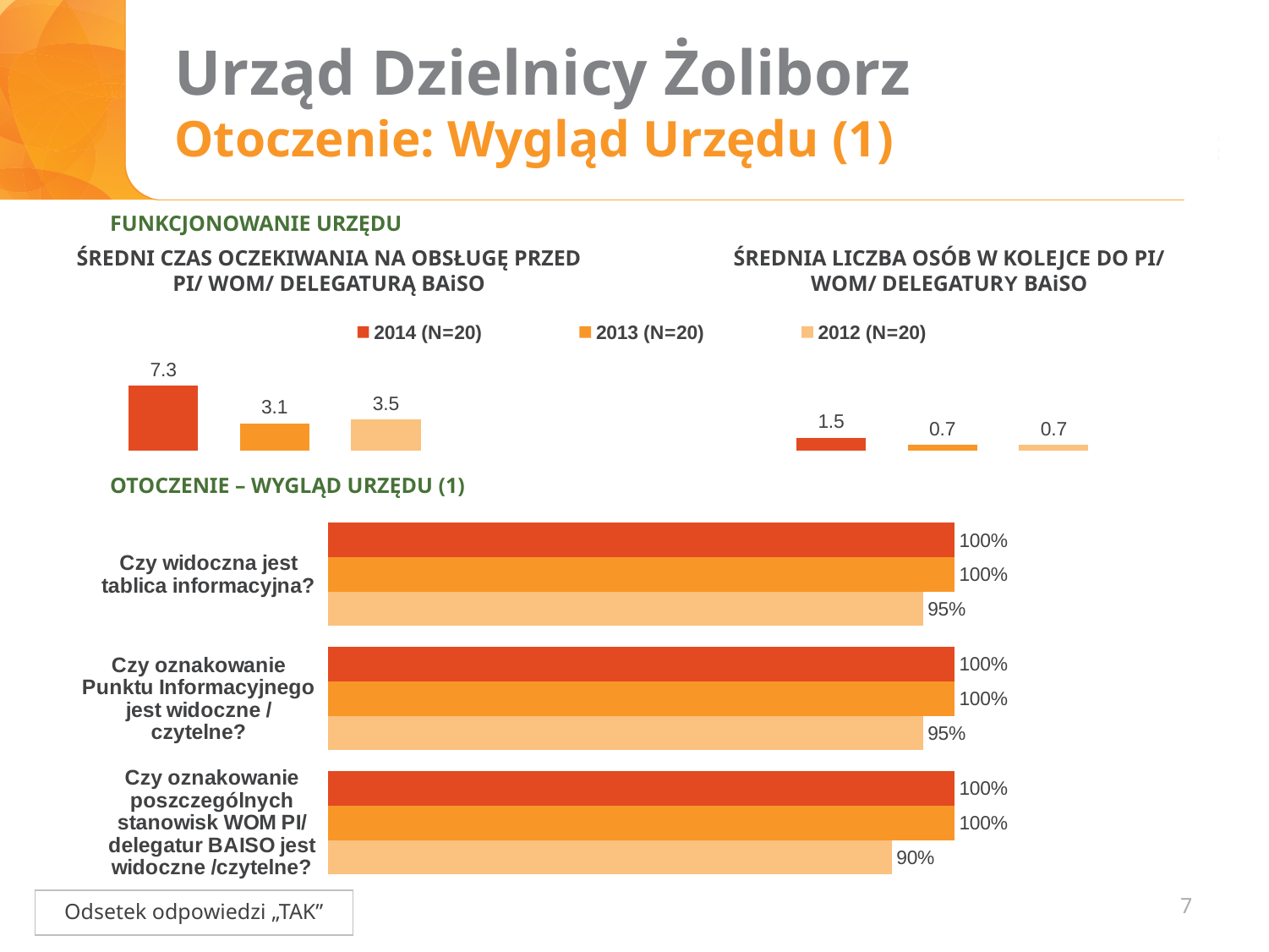
In the chart 'ŚREDNIA LICZBA OSÓB W KOLEJCE DO PI/ WOM/ DELEGATURY BAiSO', what is the value for 2014 (N=20)? 1.5 In the bottom chart 'OTOCZENIE – WYGLĄD URZĘDU (1)', what is the 2012 value for 'Czy oznakowanie poszczególnych stanowisk WOM PI/ delegatur BAISO jest widoczne /czytelne?'? 90% In the chart 'ŚREDNI CZAS OCZEKIWANIA NA OBSŁUGĘ PRZED PI/ WOM/ DELEGATURĄ BAiSO', which year has the highest value? 2014 (N=20) What type of chart is the bottom chart 'OTOCZENIE – WYGLĄD URZĘDU (1)'? Bar chart How many series does the legend above the top charts list? 3 In the chart 'ŚREDNIA LICZBA OSÓB W KOLEJCE DO PI/ WOM/ DELEGATURY BAiSO', which is larger, the value for 2014 or the value for 2013? 2014 In the chart 'ŚREDNI CZAS OCZEKIWANIA NA OBSŁUGĘ PRZED PI/ WOM/ DELEGATURĄ BAiSO', what is the value for 2014 (N=20)? 7.3 In the chart 'ŚREDNIA LICZBA OSÓB W KOLEJCE DO PI/ WOM/ DELEGATURY BAiSO', what is the value for 2012 (N=20)? 0.7 In the chart 'ŚREDNI CZAS OCZEKIWANIA NA OBSŁUGĘ PRZED PI/ WOM/ DELEGATURĄ BAiSO', what is the difference between the 2014 and 2013 values? 4.2 In the chart 'ŚREDNI CZAS OCZEKIWANIA NA OBSŁUGĘ PRZED PI/ WOM/ DELEGATURĄ BAiSO', what is the value for 2013 (N=20)? 3.1 In the bottom chart 'OTOCZENIE – WYGLĄD URZĘDU (1)', how many question categories are shown? 3 In the bottom chart 'OTOCZENIE – WYGLĄD URZĘDU (1)', what is the 2012 value for 'Czy widoczna jest tablica informacyjna?'? 95%